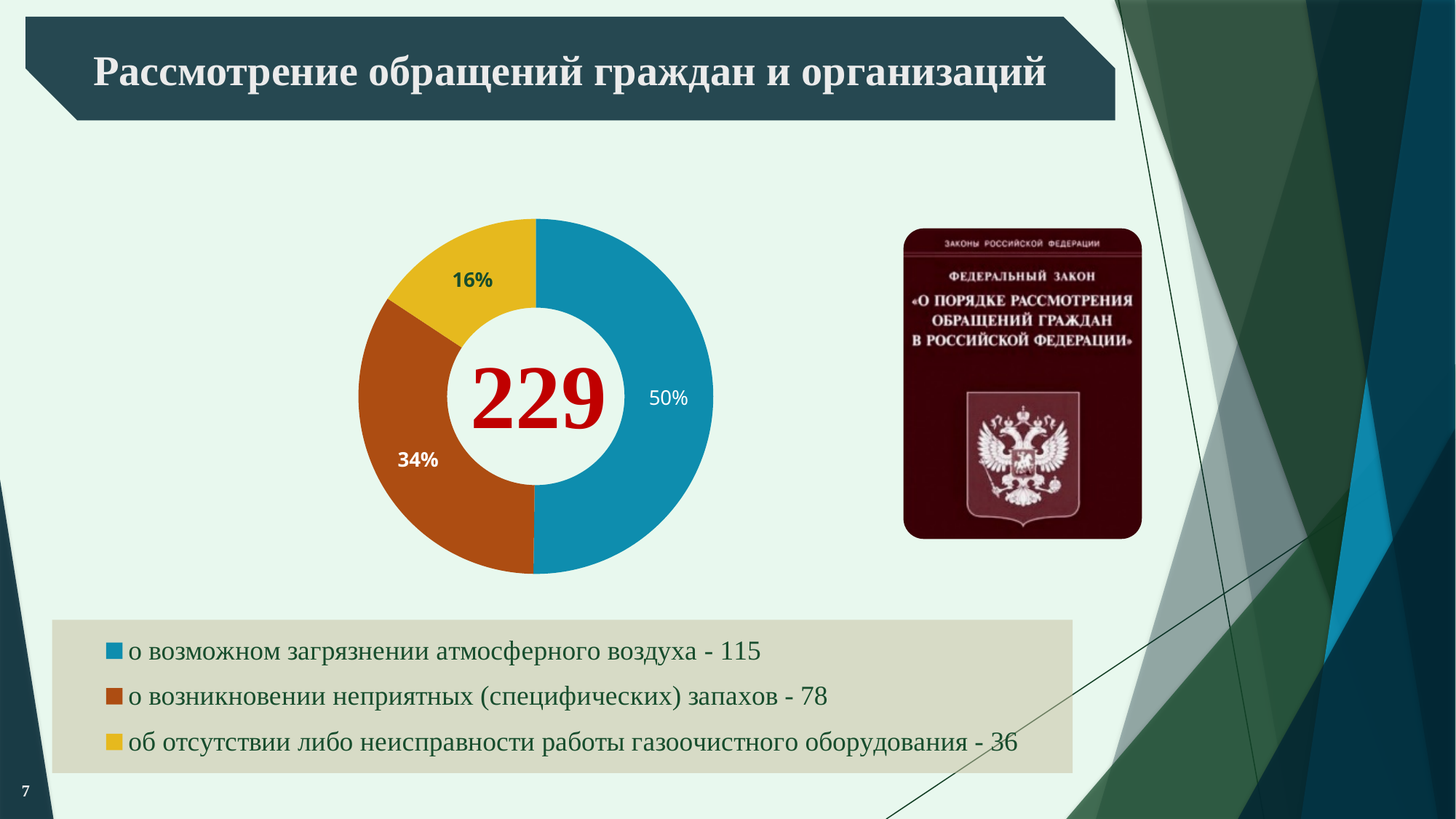
What percentage share is shown for the orange slice (о возникновении неприятных (специфических) запахов)? 34% What percentage share is shown for the yellow slice (об отсутствии либо неисправности работы газоочистного оборудования)? 16% Which category has the smallest share of the chart? об отсутствии либо неисправности работы газоочистного оборудования What is the difference in the number of appeals between 'о возможном загрязнении атмосферного воздуха' and 'о возникновении неприятных (специфических) запахов'? 37 What kind of chart is shown on the slide? Doughnut (pie) chart How many appeals are listed in the legend for 'о возможном загрязнении атмосферного воздуха'? 115 What total number is displayed in the centre of the doughnut chart? 229 Which category has the largest share of the chart? о возможном загрязнении атмосферного воздуха How many appeals are listed in the legend for 'о возникновении неприятных (специфических) запахов'? 78 How many categories does the chart show? 3 How many appeals are listed in the legend for 'об отсутствии либо неисправности работы газоочистного оборудования'? 36 What percentage share is shown for the blue slice (о возможном загрязнении атмосферного воздуха)? 50%